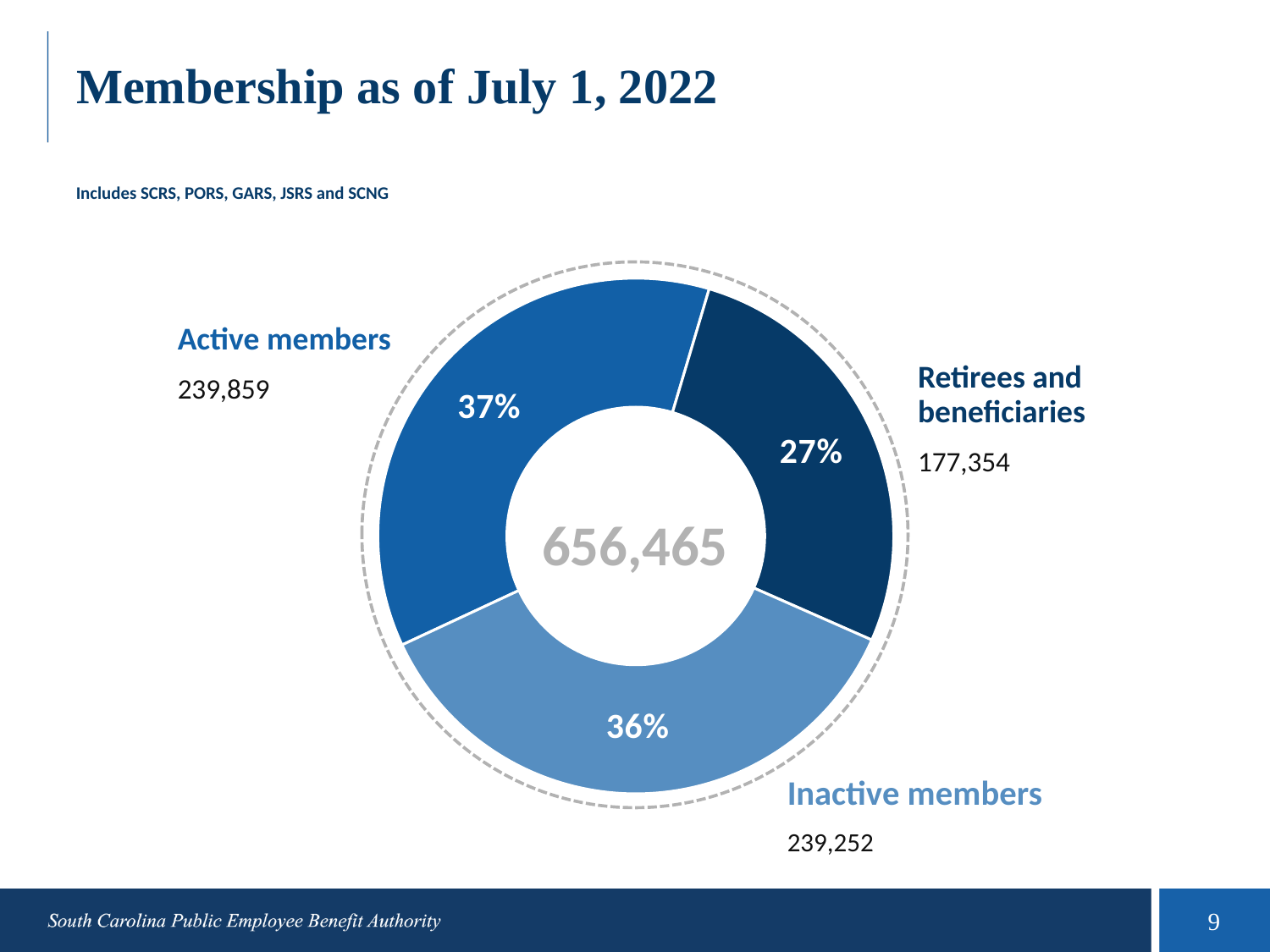
What share of the membership do Active members represent? 37% What is the total membership shown in the centre of the chart? 656,465 What is the difference between the number of Active members and the number of Retirees and beneficiaries? 62,505 How many membership categories does the chart show? 3 How many Inactive members are shown on the chart? 239,252 How many Retirees and beneficiaries are shown on the chart? 177,354 What kind of chart is shown on the slide? Donut (pie) chart Which category has the smallest number of members? Retirees and beneficiaries Which category has the largest number of members? Active members What share of the membership do Retirees and beneficiaries represent? 27% What share of the membership do Inactive members represent? 36% How many Active members are shown on the chart? 239,859